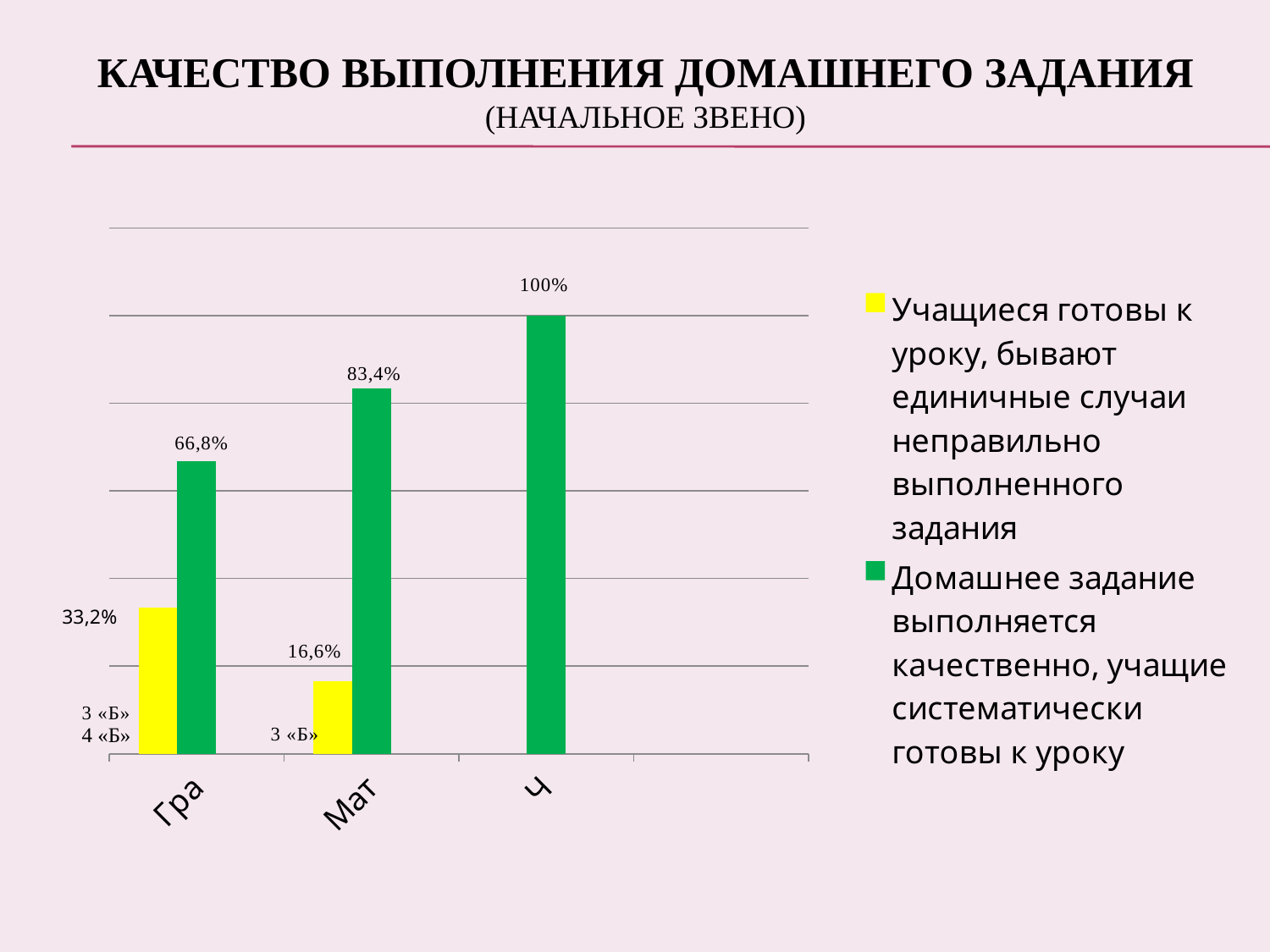
Which is larger for the category "Гра": the yellow bar or the green bar? the green bar What is the value of the yellow bar for the category labelled "Гра"? 33,2% Which category has the highest green bar? Ч What type of chart is shown on the slide? bar chart How many categories are shown on the x axis? 3 What is the value of the green bar for the category labelled "Гра"? 66,8% What is the value of the green bar for the category labelled "Ч"? 100% What is the difference between the green bar values for "Мат" and "Гра"? 16,6% What is the value of the yellow bar for the category labelled "Мат"? 16,6% What is the value of the green bar for the category labelled "Мат"? 83,4% Which category has the lowest yellow bar among those with a yellow bar? Мат How many series does the legend list? 2